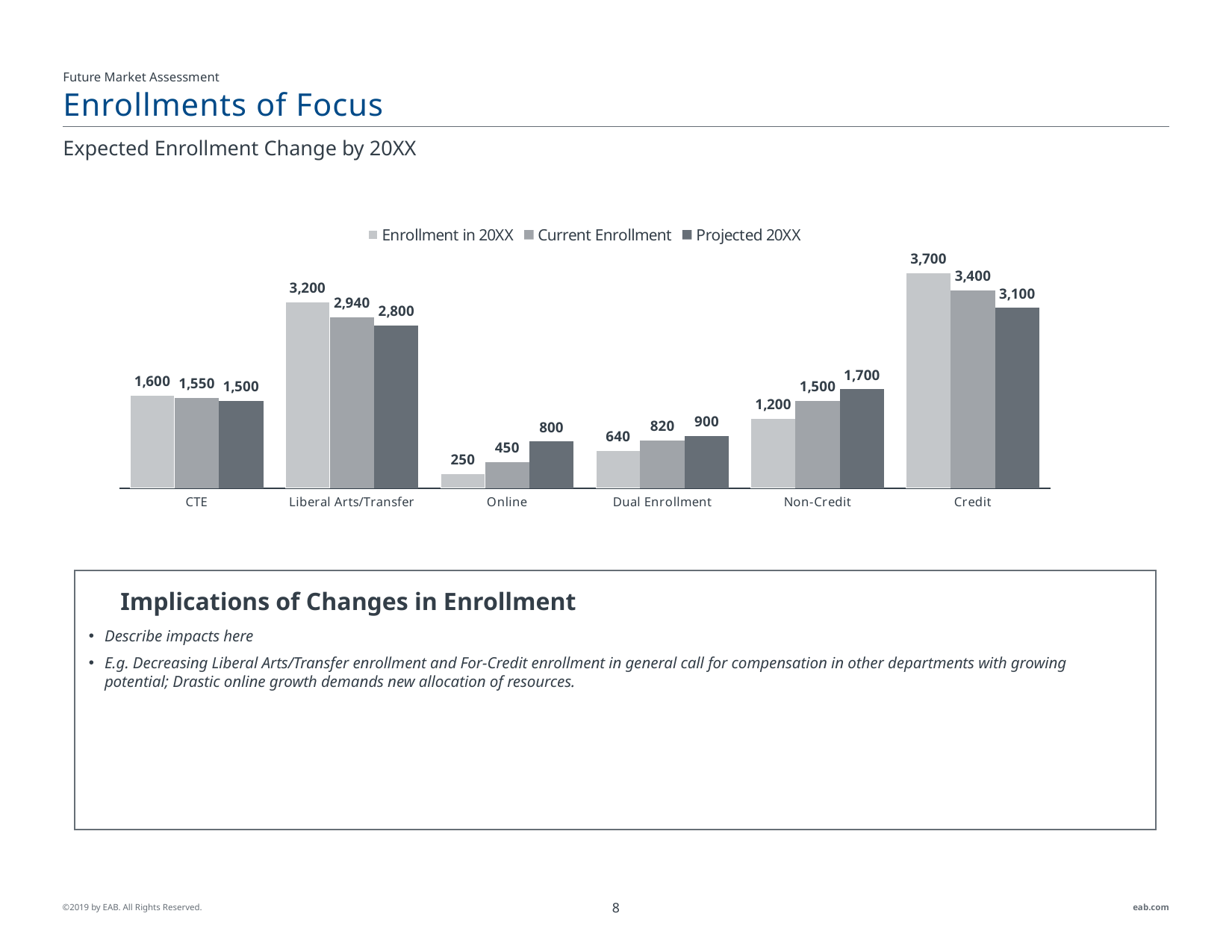
How many categories are shown on the x axis? 6 What is the difference between the Enrollment in 20XX and Projected 20XX values for Credit? 600 What is the Current Enrollment value for Liberal Arts/Transfer? 2,940 Which is larger for Dual Enrollment: Current Enrollment or Projected 20XX? Projected 20XX How many series does the legend list? 3 What is the title of the chart? Expected Enrollment Change by 20XX Which category has the lowest Enrollment in 20XX value? Online Do the values for Liberal Arts/Transfer rise or fall from Enrollment in 20XX to Projected 20XX? Fall What kind of chart is shown on the slide? Bar chart Which category has the highest Projected 20XX enrollment? Credit What is the Enrollment in 20XX value for Non-Credit? 1,200 What is the Projected 20XX enrollment for Online? 800